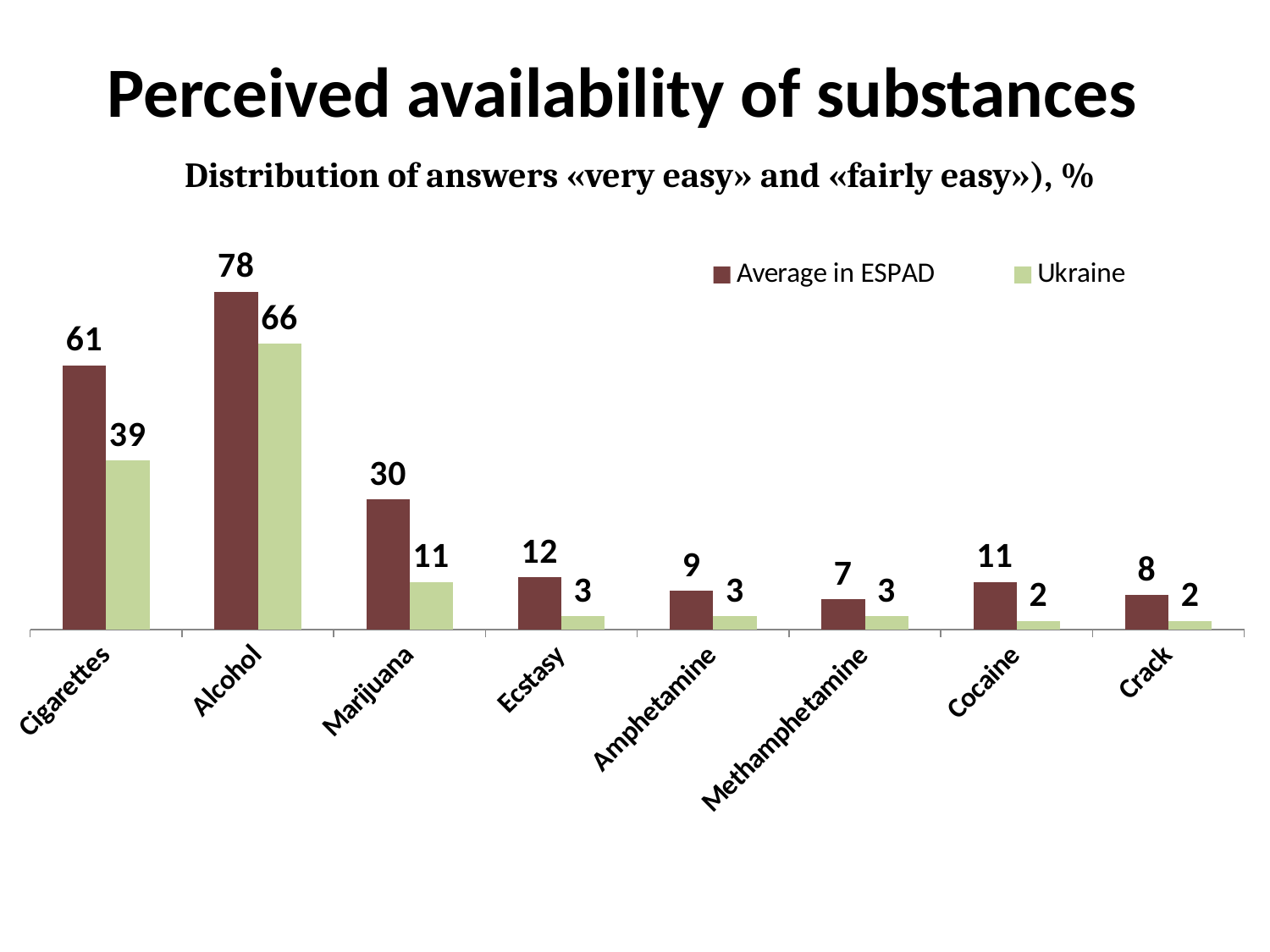
Which substance has the lowest Average in ESPAD value? Methamphetamine What is the Ukraine value for Cigarettes? 39 How many series does the legend list? 2 What kind of chart is shown on the slide? Bar chart Which series is shown in light green in the legend? Ukraine How many substances are shown on the x axis? 8 What is the difference between the Average in ESPAD and Ukraine values for Cigarettes? 22 Which substance has the highest Ukraine value? Alcohol What is the Ukraine value for Marijuana? 11 What is the difference between the Average in ESPAD values for Alcohol and Marijuana? 48 What is the Average in ESPAD value for Alcohol? 78 Which is larger for Cocaine: the Average in ESPAD value or the Ukraine value? Average in ESPAD